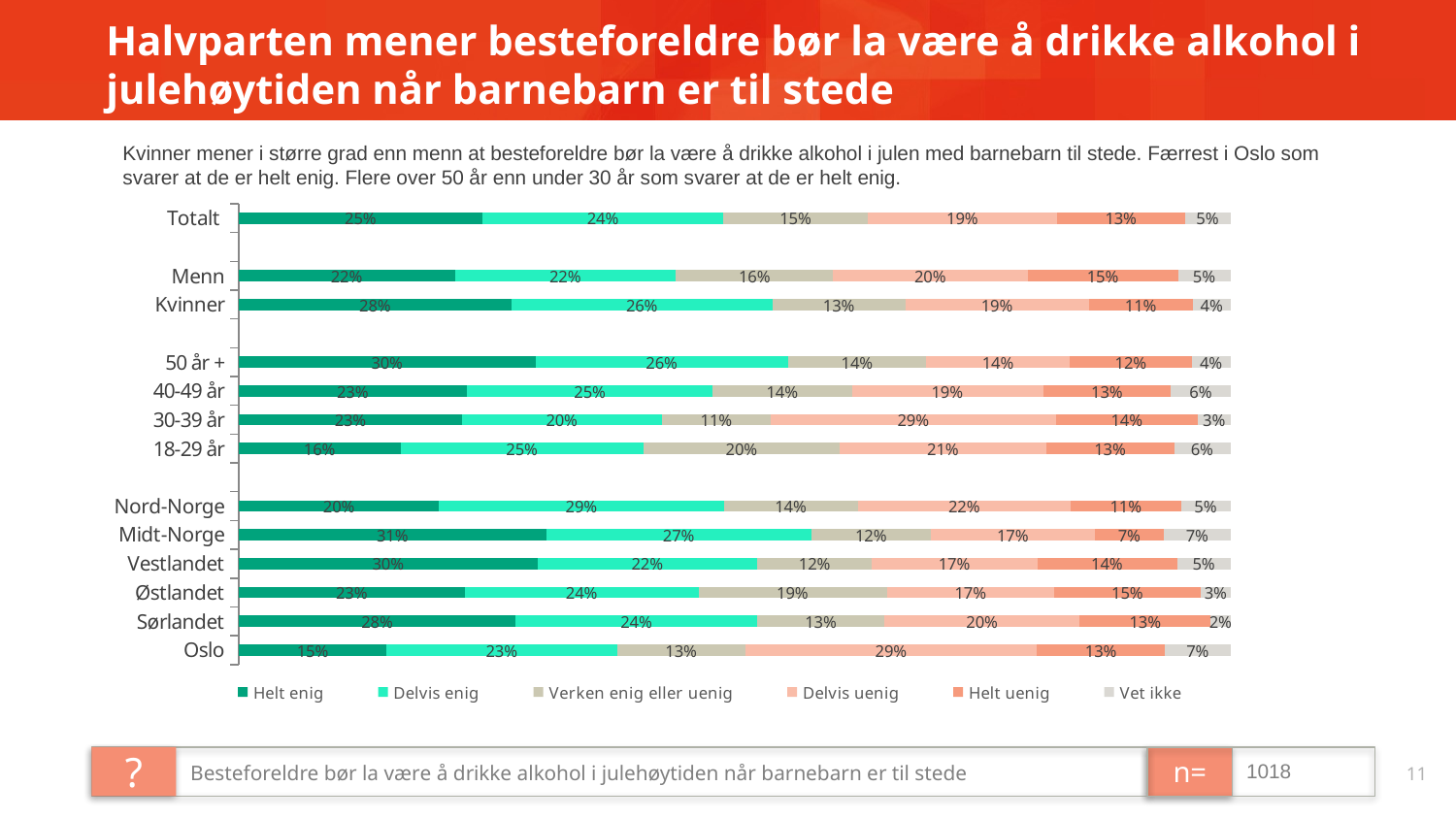
Which has a larger "Delvis enig" share, Nord-Norge or Vestlandet? Nord-Norge Which category has the lowest "Helt enig" share? Oslo What is the "Vet ikke" value for Sørlandet? 2% What percentage of Kvinner answered "Helt enig"? 28% What is the sample size (n=) shown on the slide? 1018 What is the combined share of "Helt enig" and "Delvis enig" for Totalt? 49% Which category has the highest "Helt enig" share? Midt-Norge What kind of chart is shown on the slide? Stacked bar chart What is the difference in "Helt enig" between Kvinner and Menn? 6 percentage points How many series does the legend list? 6 How many categories (bars) are shown in the chart? 13 What is the "Delvis uenig" value for Oslo? 29%